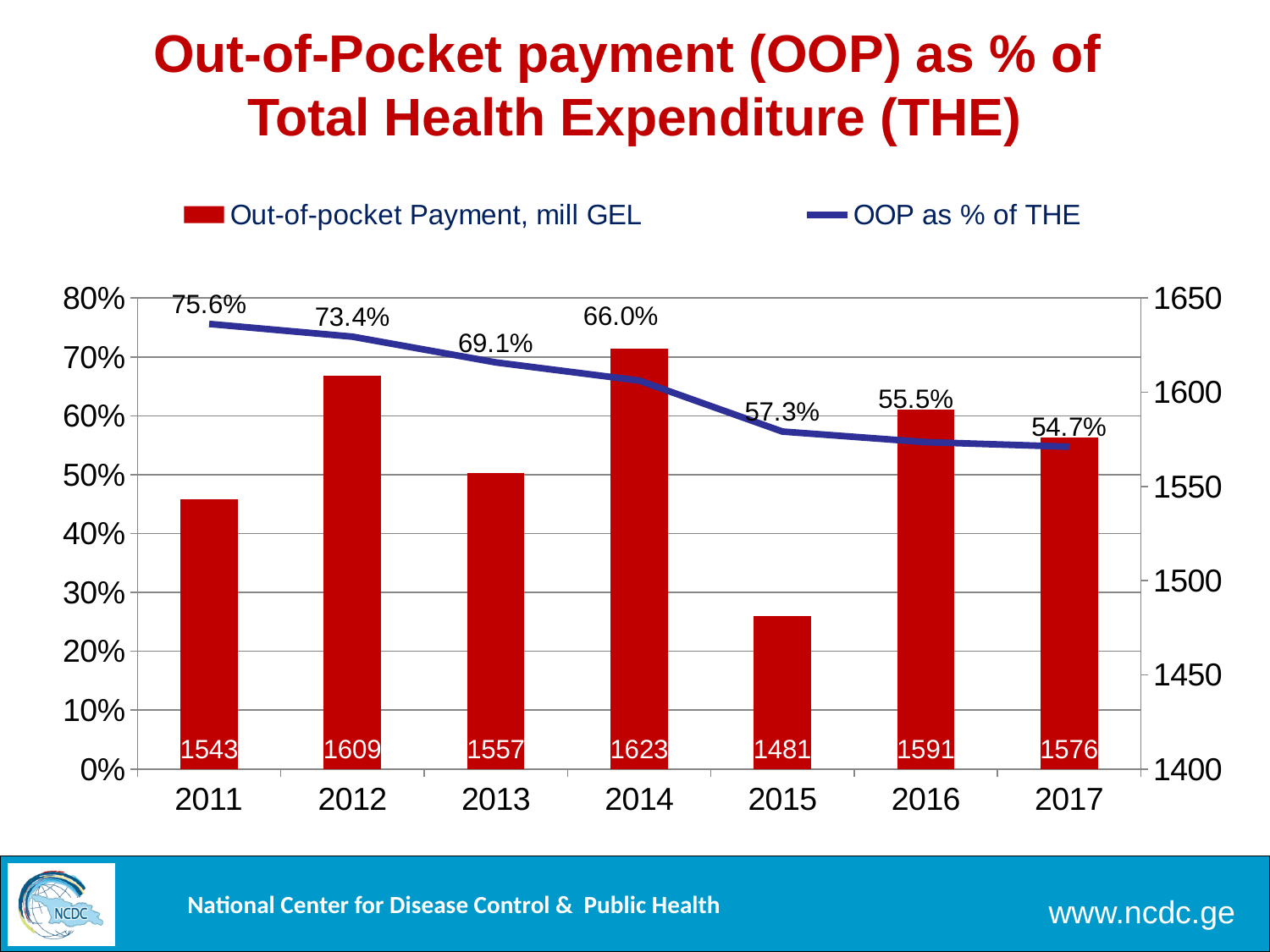
Which year had the highest Out-of-pocket Payment in mill GEL? 2014 Which year had the lowest Out-of-pocket Payment in mill GEL? 2015 What is the difference in OOP as % of THE between 2011 and 2017? 20.9% What was OOP as % of THE in 2015? 57.3% Which year had a larger Out-of-pocket Payment in mill GEL, 2016 or 2017? 2016 Which year had the highest OOP as % of THE? 2011 What was the Out-of-pocket Payment in mill GEL in 2014? 1623 What is the difference in Out-of-pocket Payment (mill GEL) between 2012 and 2011? 66 How many years are shown on the x axis? 7 What was OOP as % of THE in 2011? 75.6% How many series does the legend list? 2 Does OOP as % of THE rise or fall from 2011 to 2017? fall